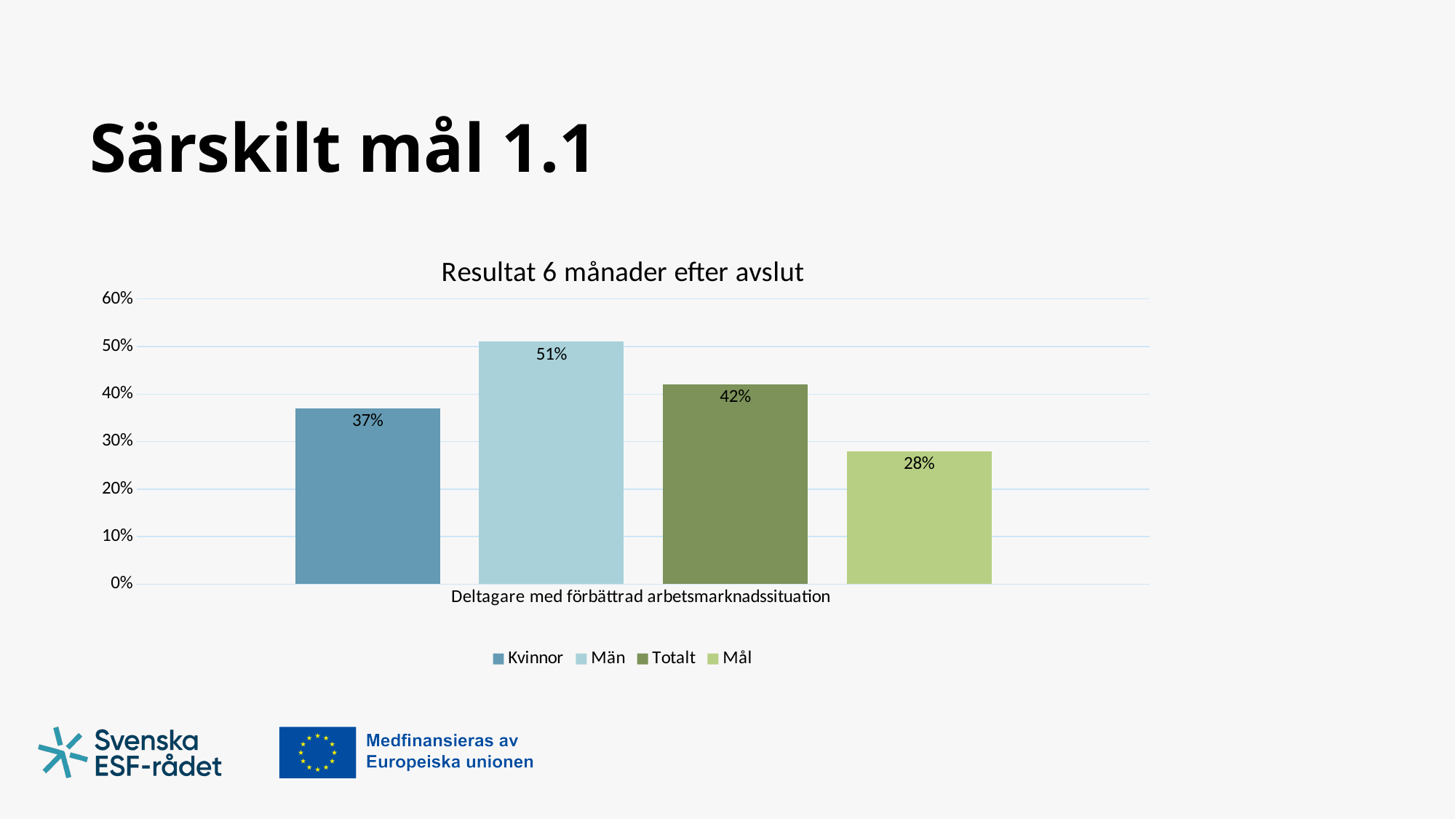
What is the difference between the values for Totalt and Mål? 14% How many series does the legend list? 4 What kind of chart is shown on the slide? Bar chart Which series has the lowest value in the chart? Mål Which is larger, the value for Kvinnor or the value for Mål? Kvinnor What is the value for Mål in the chart? 28% What is the value for Kvinnor in the chart? 37% Which series has the highest value in the chart? Män What is the title of the chart? Resultat 6 månader efter avslut What is the value for Totalt in the chart? 42% What is the difference between the values for Män and Kvinnor? 14% What is the value for Män in the chart? 51%